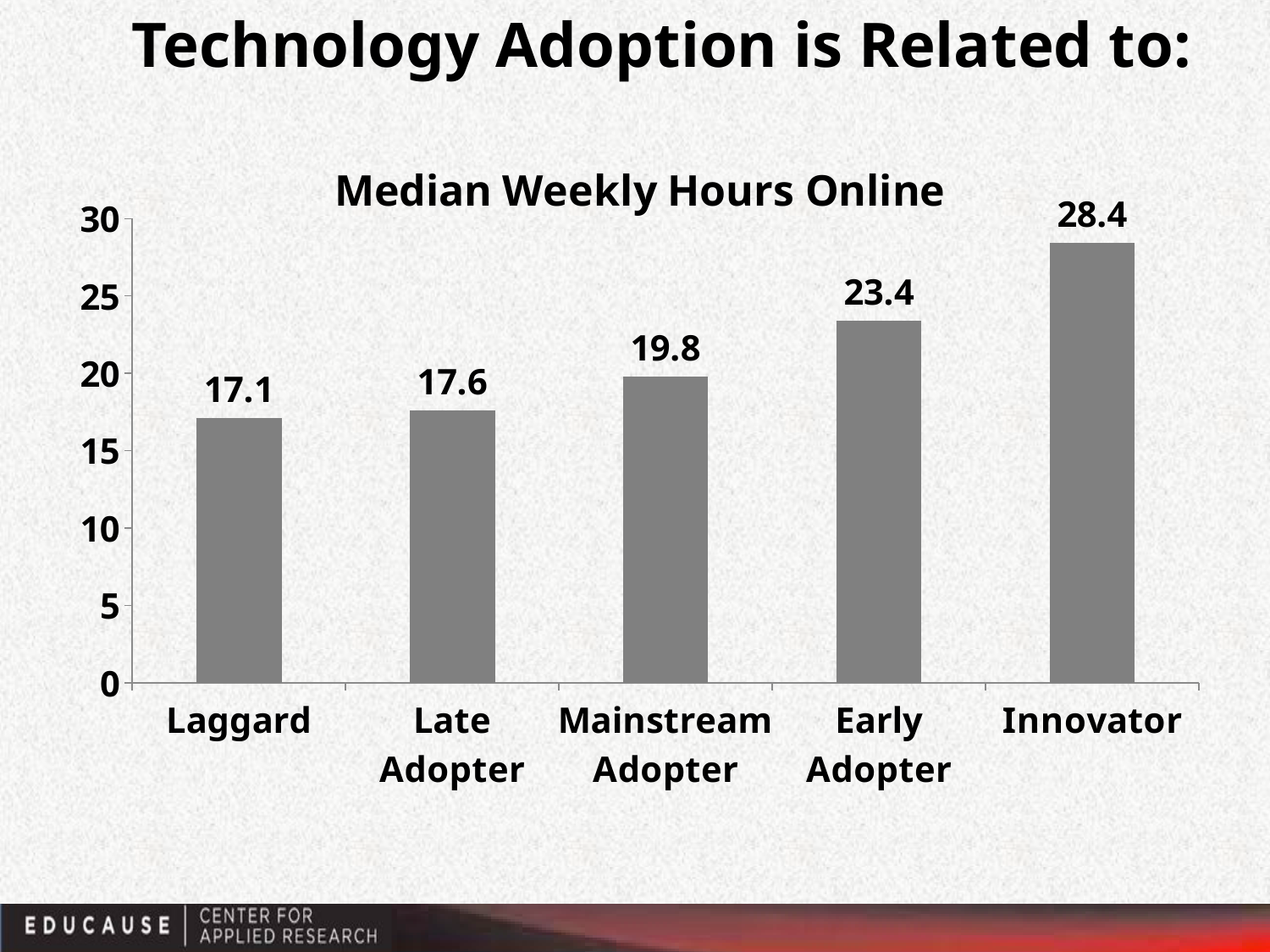
Which category has the highest median weekly hours online? Innovator Which has a higher median weekly hours online, Late Adopter or Early Adopter? Early Adopter What is the difference in median weekly hours online between Innovator and Laggard? 11.3 Is the value for Innovator greater or less than 25? greater What is the median weekly hours online for Mainstream Adopter? 19.8 What is the median weekly hours online for Laggard? 17.1 Do the values rise or fall moving from Laggard to Innovator along the x axis? rise What is the median weekly hours online for Early Adopter? 23.4 What is the difference in median weekly hours online between Early Adopter and Mainstream Adopter? 3.6 What kind of chart is shown on the slide? bar chart How many categories are shown on the x axis? 5 Which category has the lowest median weekly hours online? Laggard